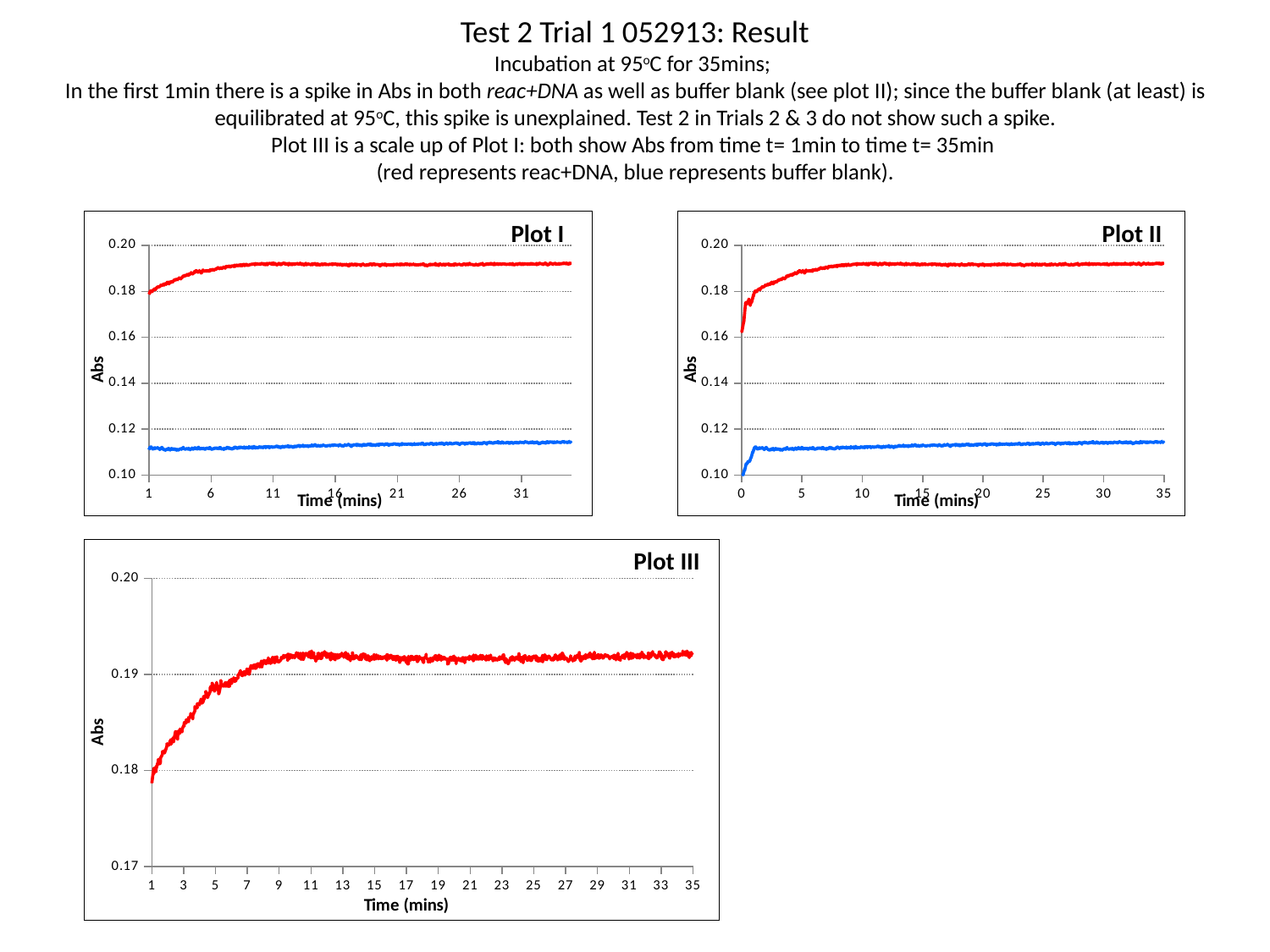
What kind of chart is Plot I? line chart What is the y-axis title of Plot III? Abs In Plot I, how many lines are plotted? 2 What is the x-axis title of Plot II? Time (mins) In Plot III, is the value of the red line at 35 mins greater or less than 0.19? greater In Plot II, is the value of the red line at 0 mins greater or less than 0.18? less In Plot III, does the red line rise or fall between 1 min and 9 mins? rise In Plot III, how many lines are plotted? 1 In Plot II, is the value of the red line at 30 mins greater or less than 0.18? greater In Plot I, which line has the larger value at 20 mins, the red line or the blue line? the red line